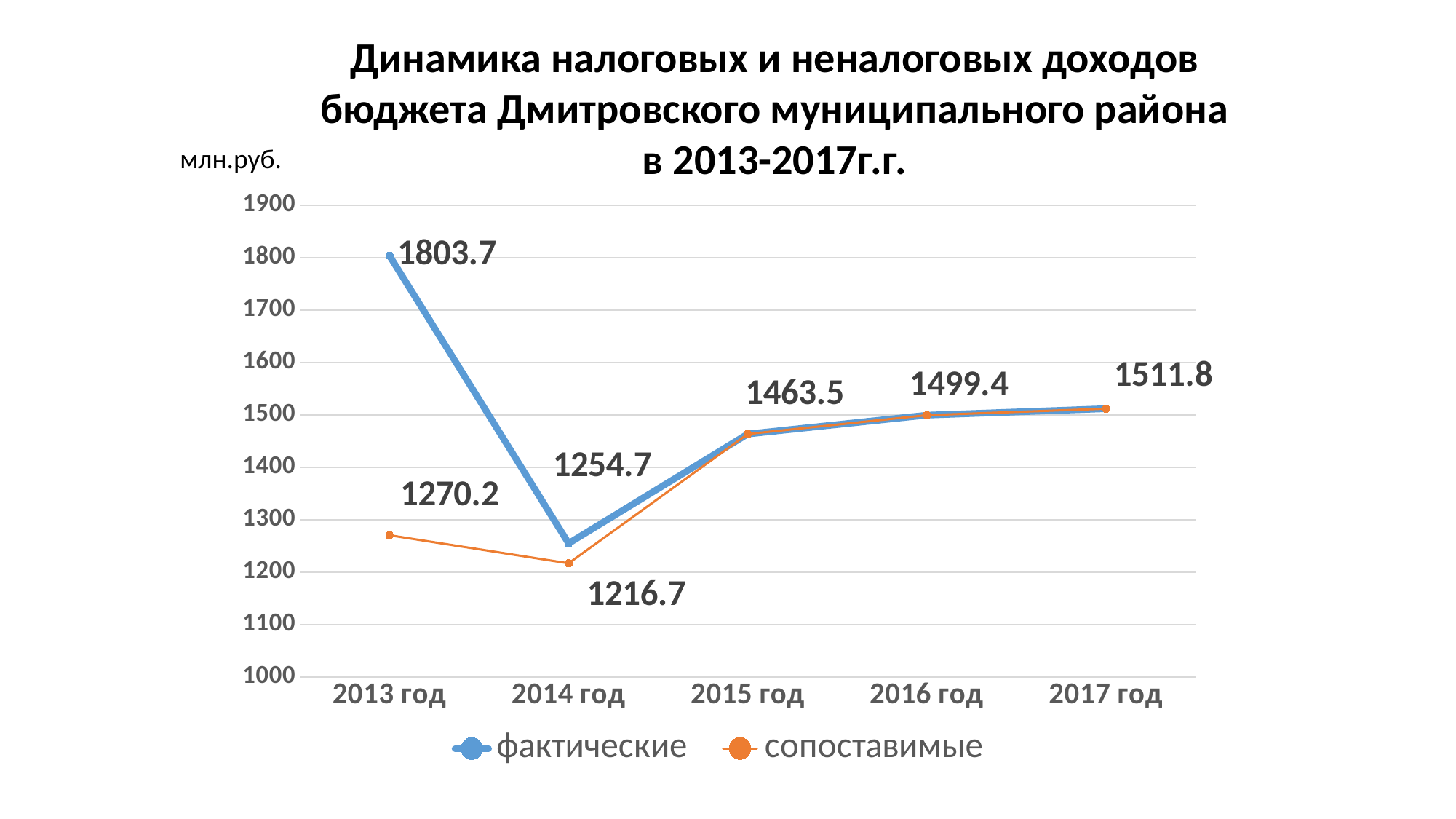
What is the value of the фактические series for 2013 год? 1803.7 In which year is the фактические series highest? 2013 год What is the value of the сопоставимые series for 2014 год? 1216.7 What kind of chart is shown on the slide? line chart How many series does the legend list? 2 In which year is the сопоставимые series lowest? 2014 год Is the сопоставимые value for 2013 год greater or less than 1300? less What is the difference between the фактические and сопоставимые values for 2013 год? 533.5 What value is labelled at 2017 год? 1511.8 What value is labelled at 2016 год? 1499.4 Which series has the larger value in 2013 год, фактические or сопоставимые? фактические How many years are shown on the x axis? 5